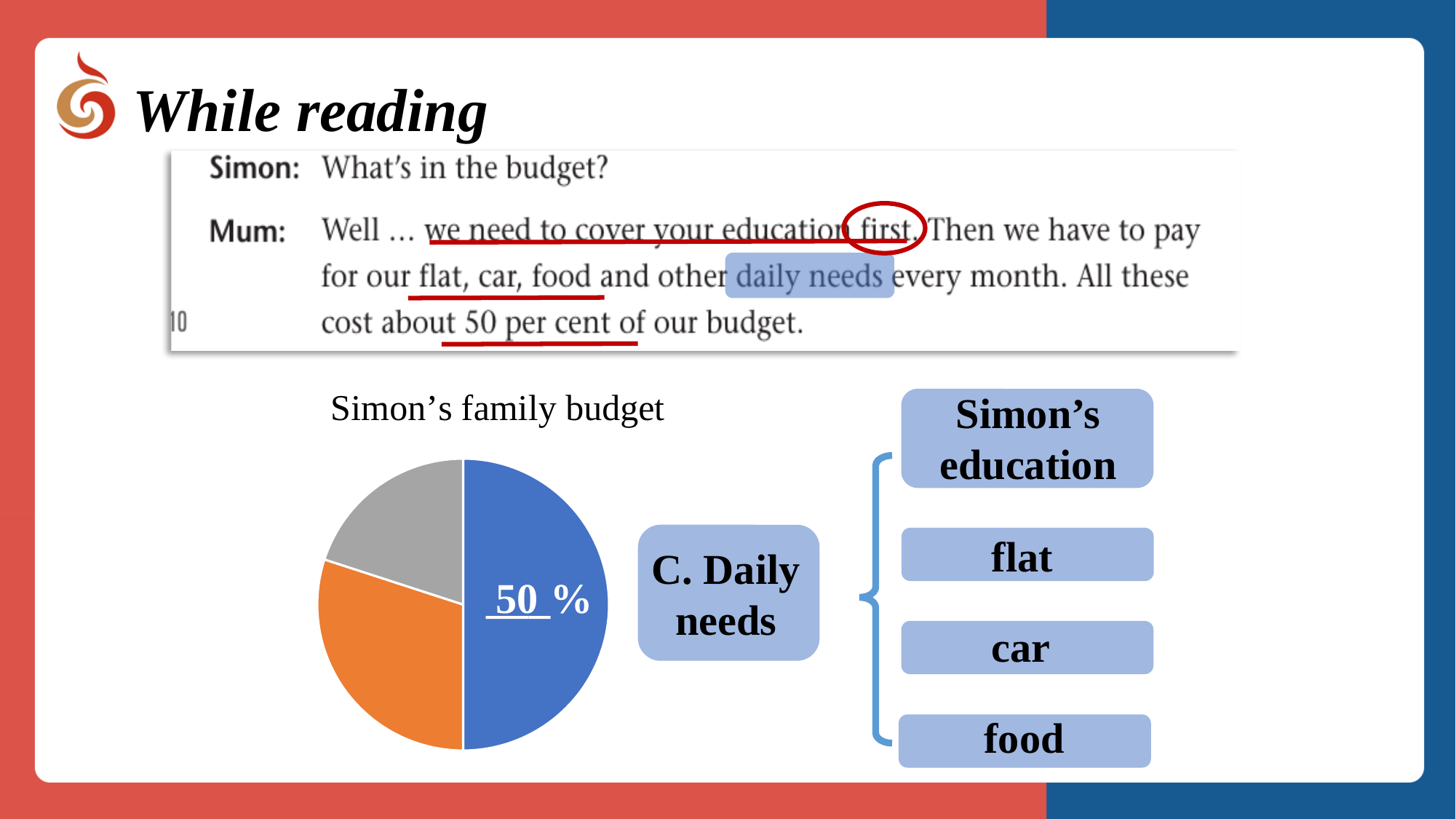
What colour is the slice labelled 50 % in the pie chart? blue What kind of chart is shown on the slide? pie chart What is the title of the pie chart? Simon's family budget Which slice of the pie chart is the largest? the blue slice What share of Simon's family budget does the blue slice (daily needs) take up? 50 % Which is larger in the pie chart, the blue slice or the orange slice? the blue slice How many slices does the pie chart have? 3 What percentage is printed on the blue slice of the pie chart? 50 % Which is larger in the pie chart, the orange slice or the grey slice? the orange slice Which slice of the pie chart is the smallest? the grey slice